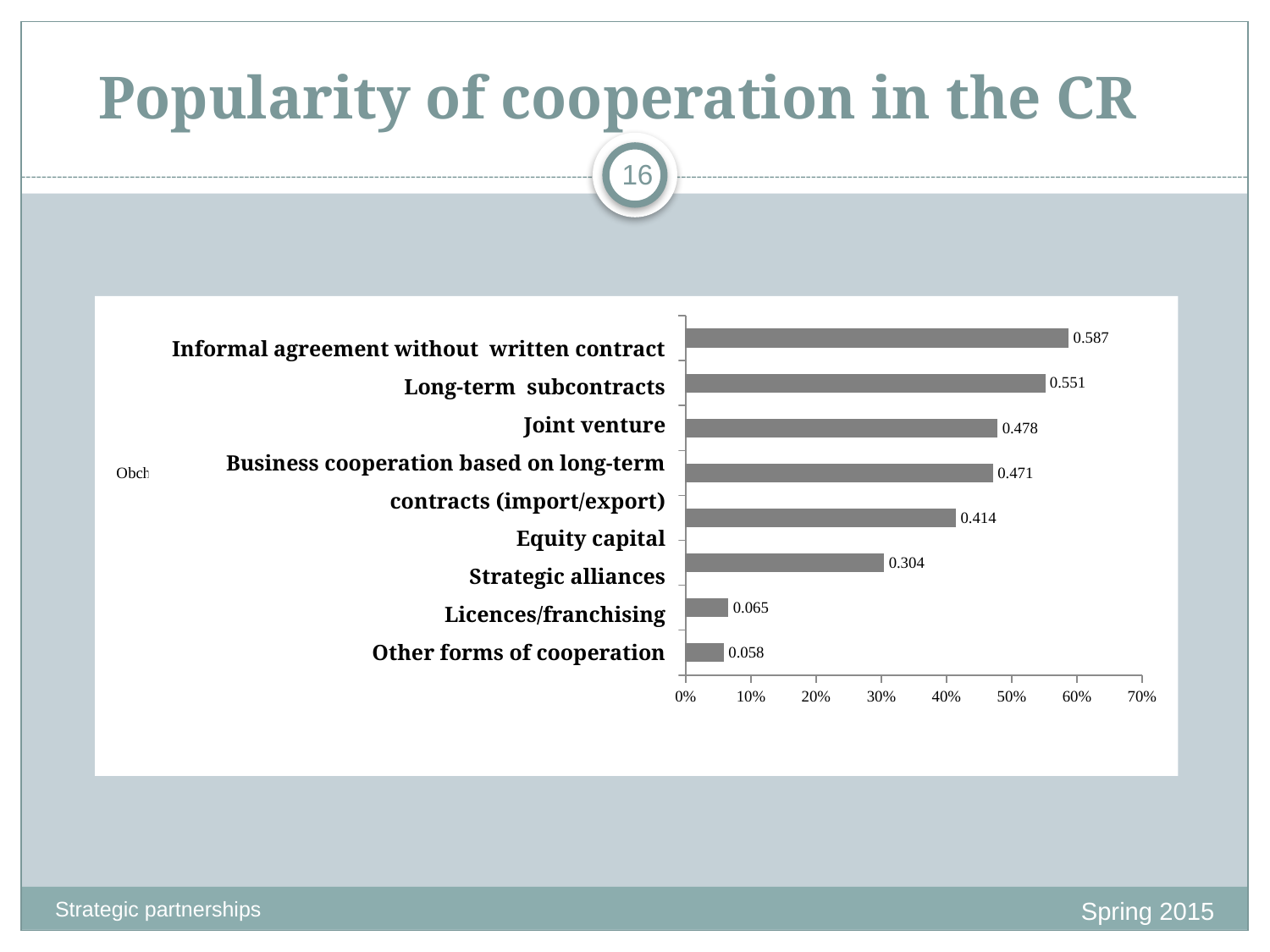
What is the title of the slide containing the chart? Popularity of cooperation in the CR Which is larger, the value for Equity capital or the value for Strategic alliances? Equity capital What is the value for Licences/franchising? 0.065 Which category has the highest value? Informal agreement without written contract Which category has the lowest value? Other forms of cooperation What is the value for Joint venture? 0.478 What is the value for Strategic alliances? 0.304 How many categories are shown in the chart? 8 Is the value for Long-term subcontracts greater or less than 50%? greater What is the difference between the values for Long-term subcontracts and Equity capital? 0.137 What is the value for Informal agreement without written contract? 0.587 What kind of chart is shown on the slide? Bar chart